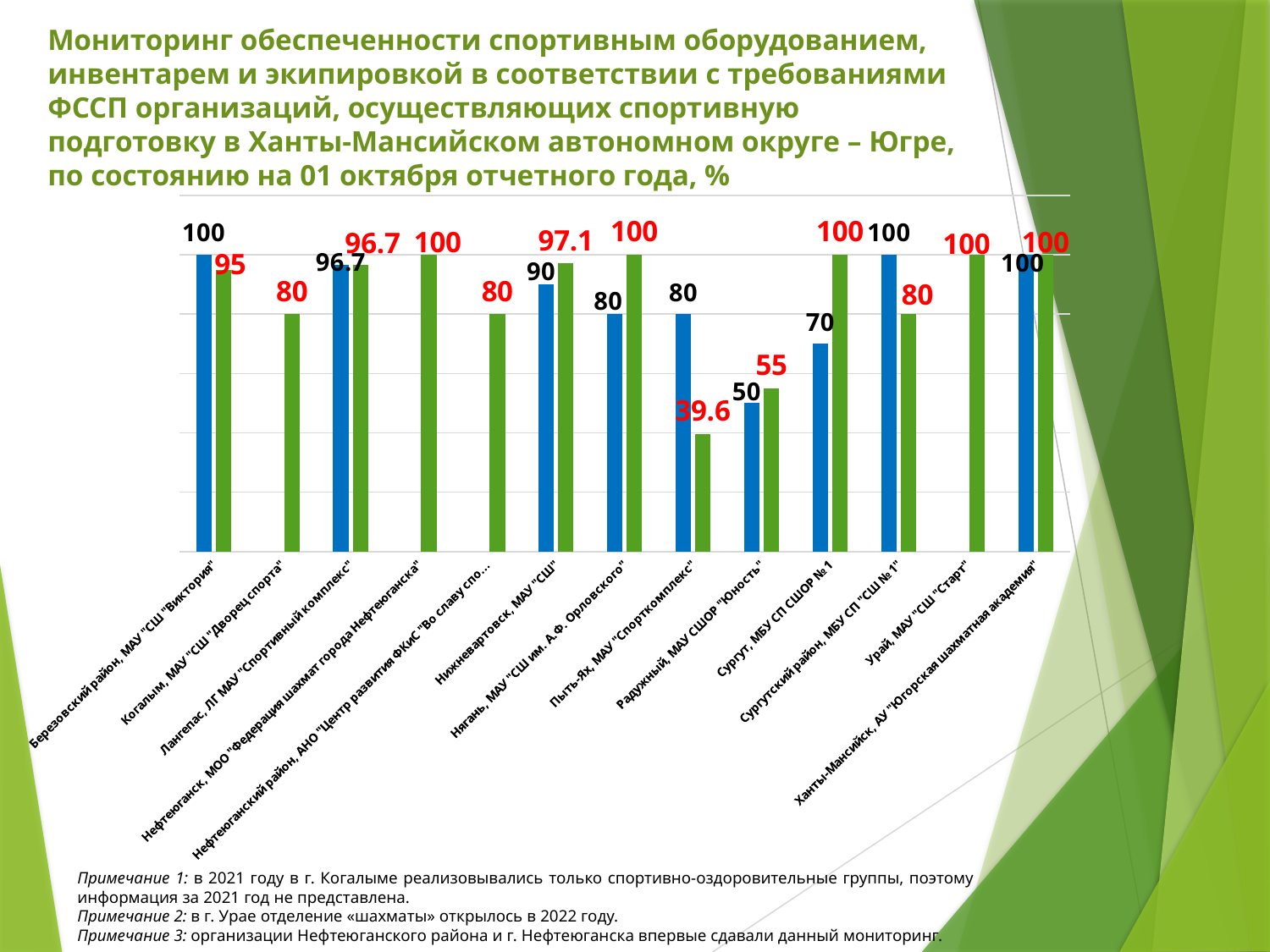
Which is larger for Сургутский район, МБУ СП "СШ №1": the blue bar or the green bar? the blue bar What is the value of the blue bar for Радужный, МАУ СШОР "Юность"? 50 What is the value of the green bar for Пыть-Ях, МАУ "Спорткомплекс"? 39.6 Which organisation has the lowest green bar value? Пыть-Ях, МАУ "Спорткомплекс" How many organisations (categories) are shown on the x axis of the chart? 13 What is the value of the blue bar for Сургут, МБУ СП СШОР № 1? 70 What colours are the two series of bars in the chart? blue and green What is the difference between the green and blue bar values for Сургут, МБУ СП СШОР № 1? 30 What is the value of the green bar for Нижневартовск, МАУ "СШ"? 97.1 What is the difference between the blue and green bar values for Пыть-Ях, МАУ "Спорткомплекс"? 40.4 Which is larger for Радужный, МАУ СШОР "Юность": the blue bar or the green bar? the green bar What type of chart is shown on the slide? bar chart